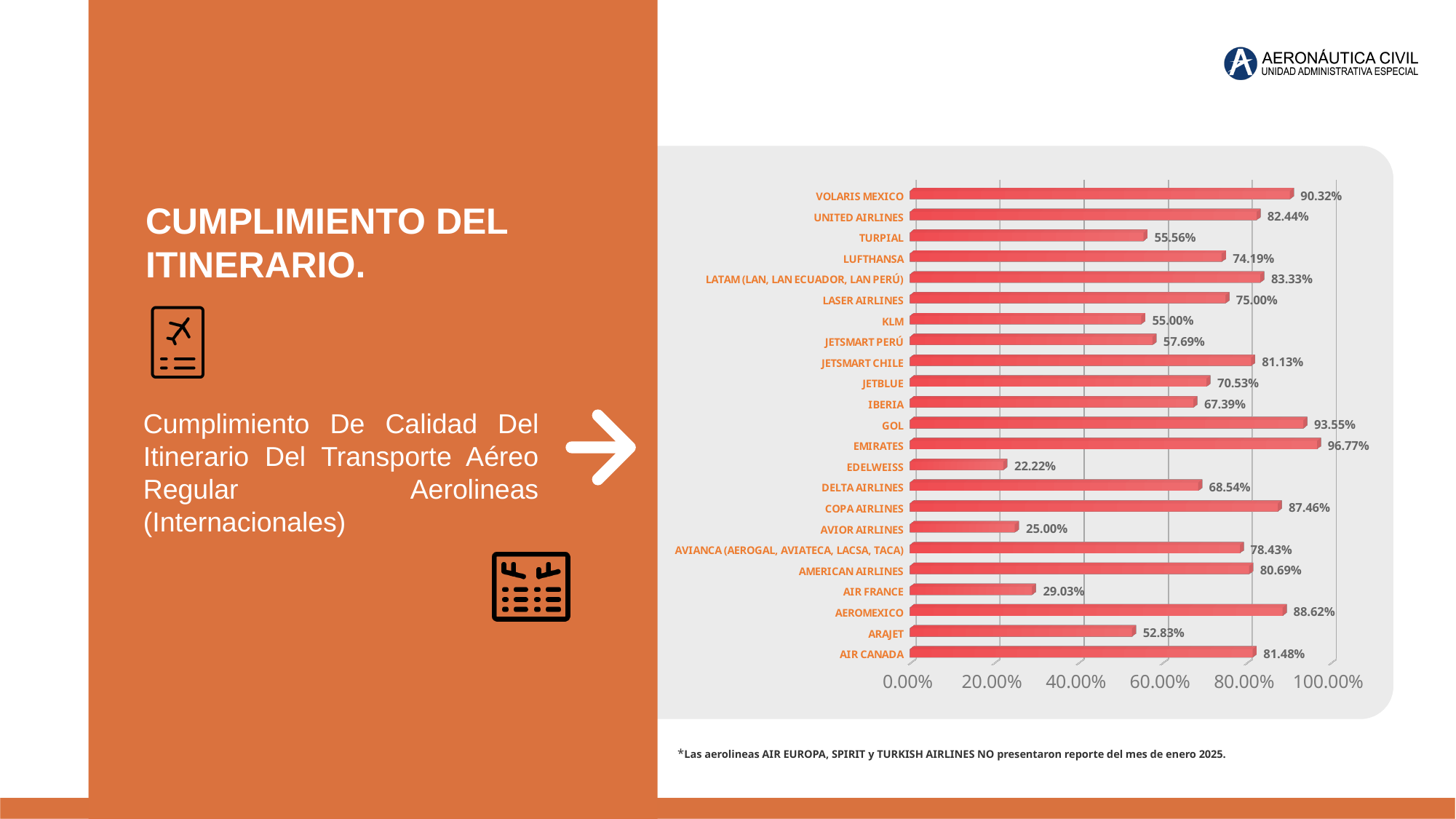
What is the value for LATAM (LAN, LAN ECUADOR, LAN PERÚ)? 83.33% How many airlines are shown in the chart? 23 Which airline has the highest value? EMIRATES What is the value for EDELWEISS? 22.22% Is the value for ARAJET greater or less than 60.00%? less What is the value for AIR CANADA? 81.48% Which is larger, the value for AIR FRANCE or the value for AVIOR AIRLINES? AIR FRANCE What is the difference between the values for VOLARIS MEXICO and UNITED AIRLINES? 7.88% Which airline has the lowest value? EDELWEISS What kind of chart is shown on the slide? bar chart What is the maximum value shown on the horizontal axis? 100.00% What is the value for EMIRATES? 96.77%